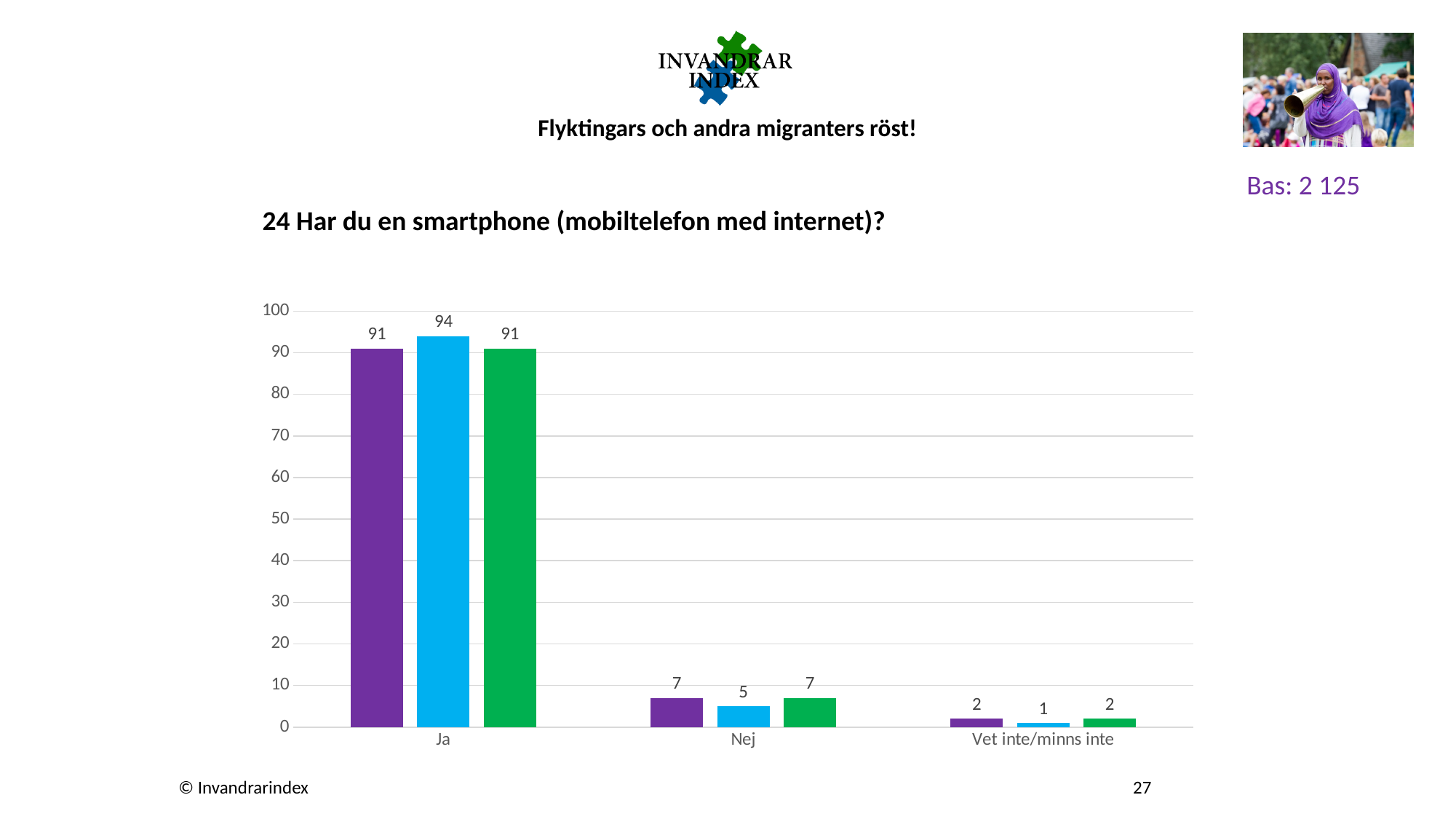
What is the title of the chart? 24 Har du en smartphone (mobiltelefon med internet)? Which category has the lowest values in the chart? Vet inte/minns inte Which category has the highest values in the chart? Ja What is the value of the blue bar for "Vet inte/minns inte"? 1 How many categories are shown on the x axis? 3 What is the value of the purple bar for "Nej"? 7 What kind of chart is shown on the slide? bar chart What is the difference between the blue bar and the purple bar for "Ja"? 3 Is the value of the purple bar for "Ja" greater or less than 80? greater What is the value of the green bar for "Ja"? 91 For "Nej", which is larger: the purple bar or the blue bar? the purple bar What is the value of the blue bar for "Ja"? 94